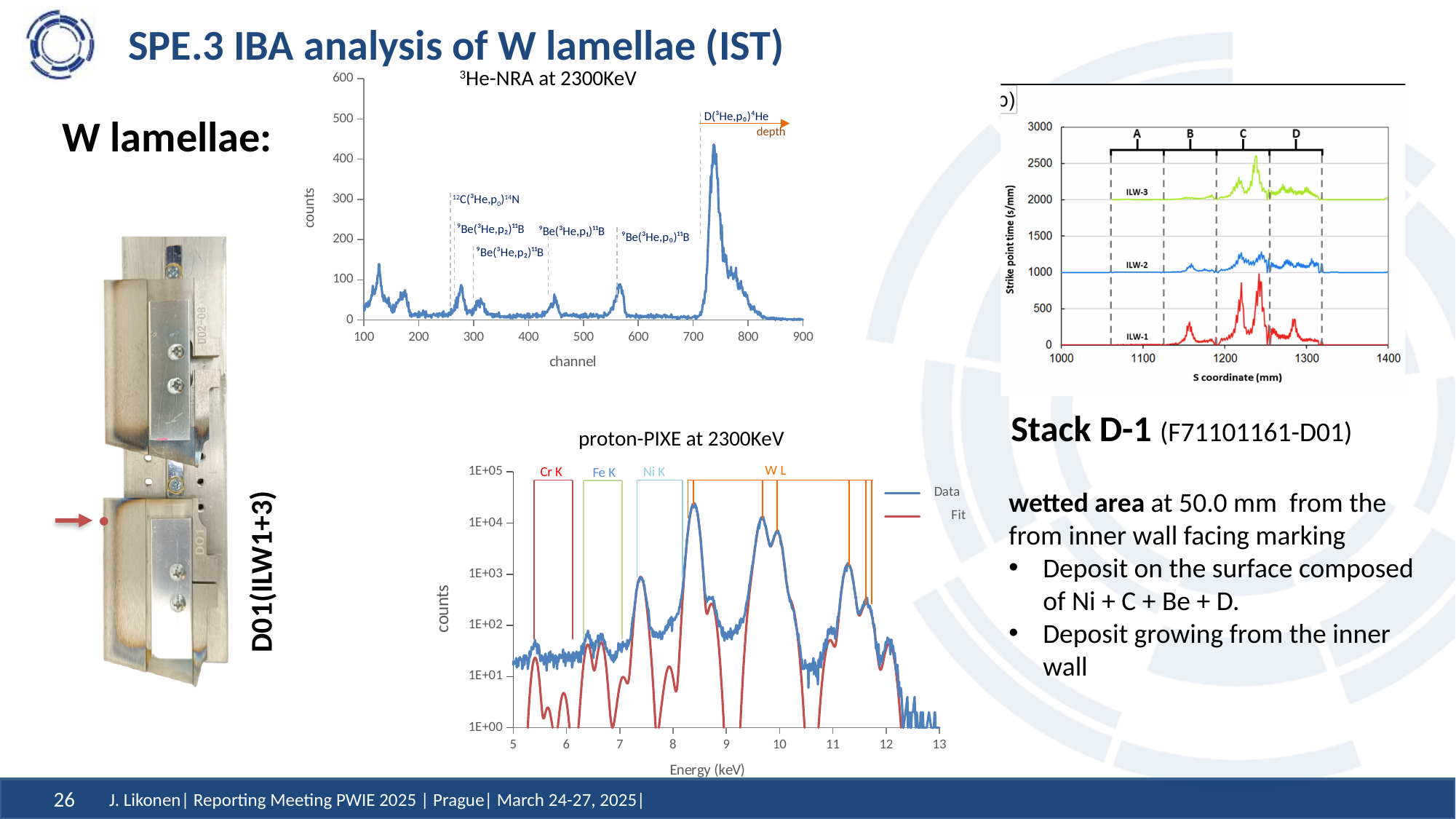
In the "proton-PIXE at 2300KeV" chart, what colour is the "Data" series? blue In the "3He-NRA at 2300KeV" chart, is the peak near channel 280 greater or less than 200 counts? less In the strike point time chart at the top right, how many ILW series are plotted? 3 In the "proton-PIXE at 2300KeV" chart, is the peak near 8.4 keV greater or less than 1E+04 counts? greater In the "proton-PIXE at 2300KeV" chart, which is larger: the peak near 8.4 keV or the peak near 11.3 keV? the peak near 8.4 keV How many series does the legend of the "proton-PIXE at 2300KeV" chart list? 2 In the "proton-PIXE at 2300KeV" chart, is the peak near 11.3 keV greater or less than 1E+04 counts? less What kind of chart is the "3He-NRA at 2300KeV" chart? line chart In the strike point time chart at the top right, which series reaches the highest strike point time? ILW-3 In the "3He-NRA at 2300KeV" chart, what is the label of the x axis? channel